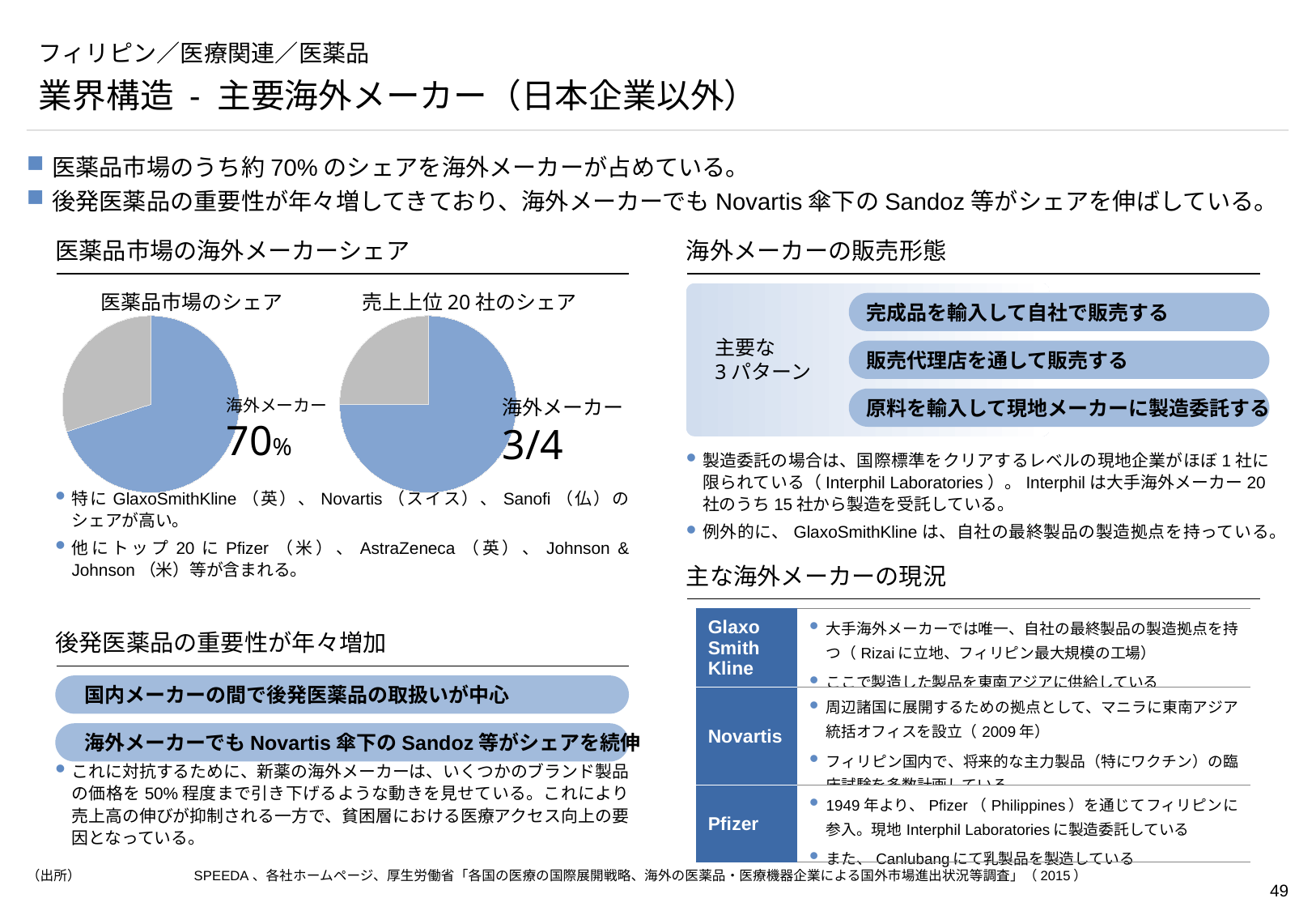
In the pie chart titled 売上上位20社のシェア, is the 海外メーカー slice larger or smaller than half of the pie? Larger What colour is the 海外メーカー slice in the pie charts? Blue How many slices does the pie chart titled 売上上位20社のシェア have? 2 What kind of chart is used for 売上上位20社のシェア? Pie chart In the pie chart titled 医薬品市場のシェア, what share is shown for 海外メーカー? 70% Which pie chart shows a larger share for 海外メーカー, 医薬品市場のシェア or 売上上位20社のシェア? 売上上位20社のシェア How many pie charts are shown under the heading 医薬品市場の海外メーカーシェア? 2 In the pie chart titled 医薬品市場のシェア, is the 海外メーカー slice larger or smaller than half of the pie? Larger In the pie chart titled 売上上位20社のシェア, what share is shown for 海外メーカー? 3/4 What kind of chart is used for 医薬品市場のシェア? Pie chart How many slices does the pie chart titled 医薬品市場のシェア have? 2 What is the title of the pie chart on the left under 医薬品市場の海外メーカーシェア? 医薬品市場のシェア